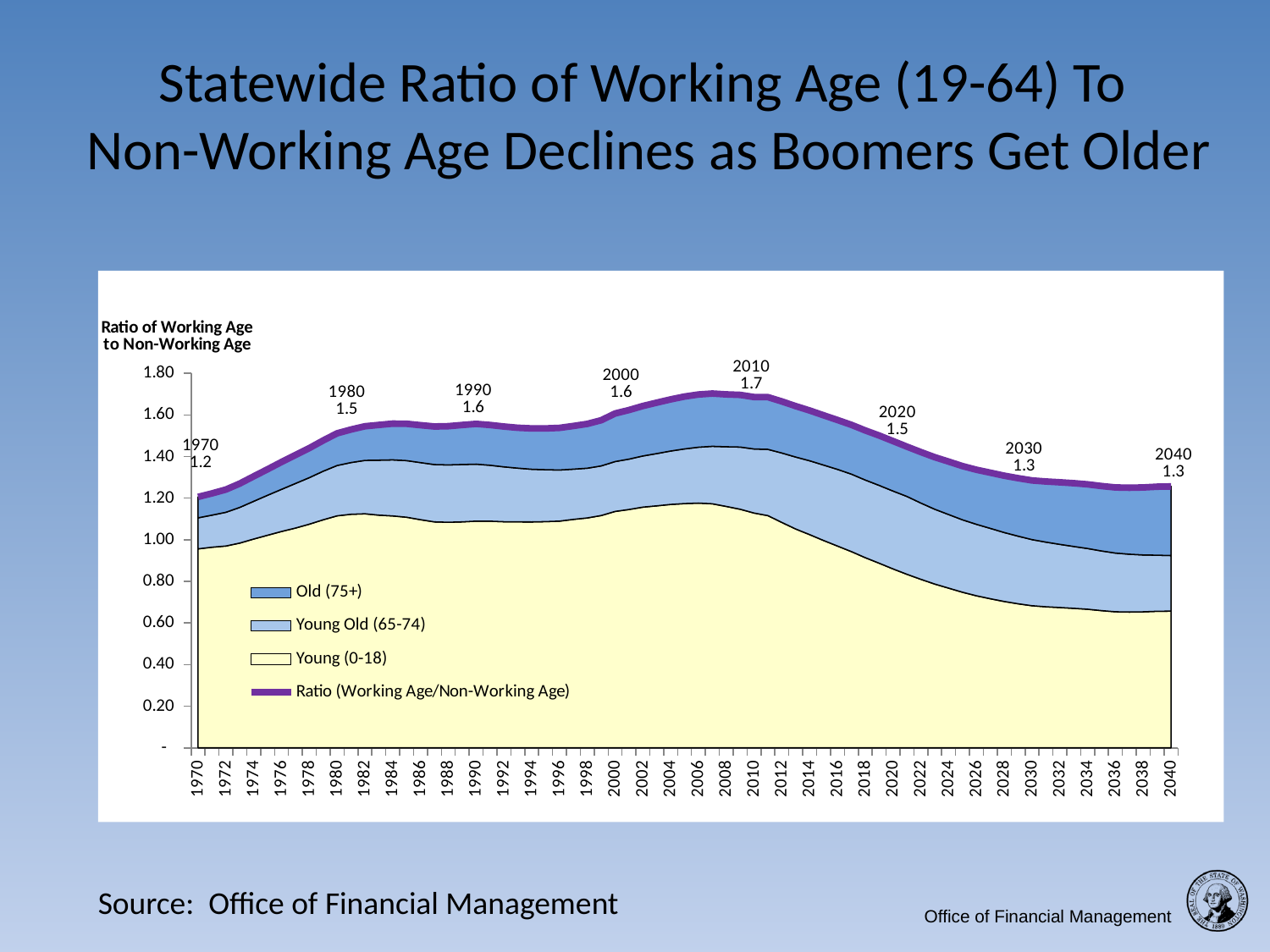
What is the difference between the labelled ratio values for 2010 and 2040? 0.4 Does the Ratio (Working Age/Non-Working Age) line rise or fall between 2010 and 2040? fall Is the value of the Young (0-18) area in 2040 greater or less than 0.80? less What is the label shown above the vertical axis of the chart? Ratio of Working Age to Non-Working Age What is the labelled value of the Ratio (Working Age/Non-Working Age) line in 2020? 1.5 How many years have a printed data label on the ratio line? 8 How many series does the legend list? 4 What is the labelled value of the Ratio (Working Age/Non-Working Age) line in 1970? 1.2 What is the labelled value of the Ratio (Working Age/Non-Working Age) line in 2010? 1.7 Which year has a higher labelled ratio value, 1980 or 2030? 1980 In which labelled year is the Ratio (Working Age/Non-Working Age) lowest? 1970 In which labelled year is the Ratio (Working Age/Non-Working Age) highest? 2010